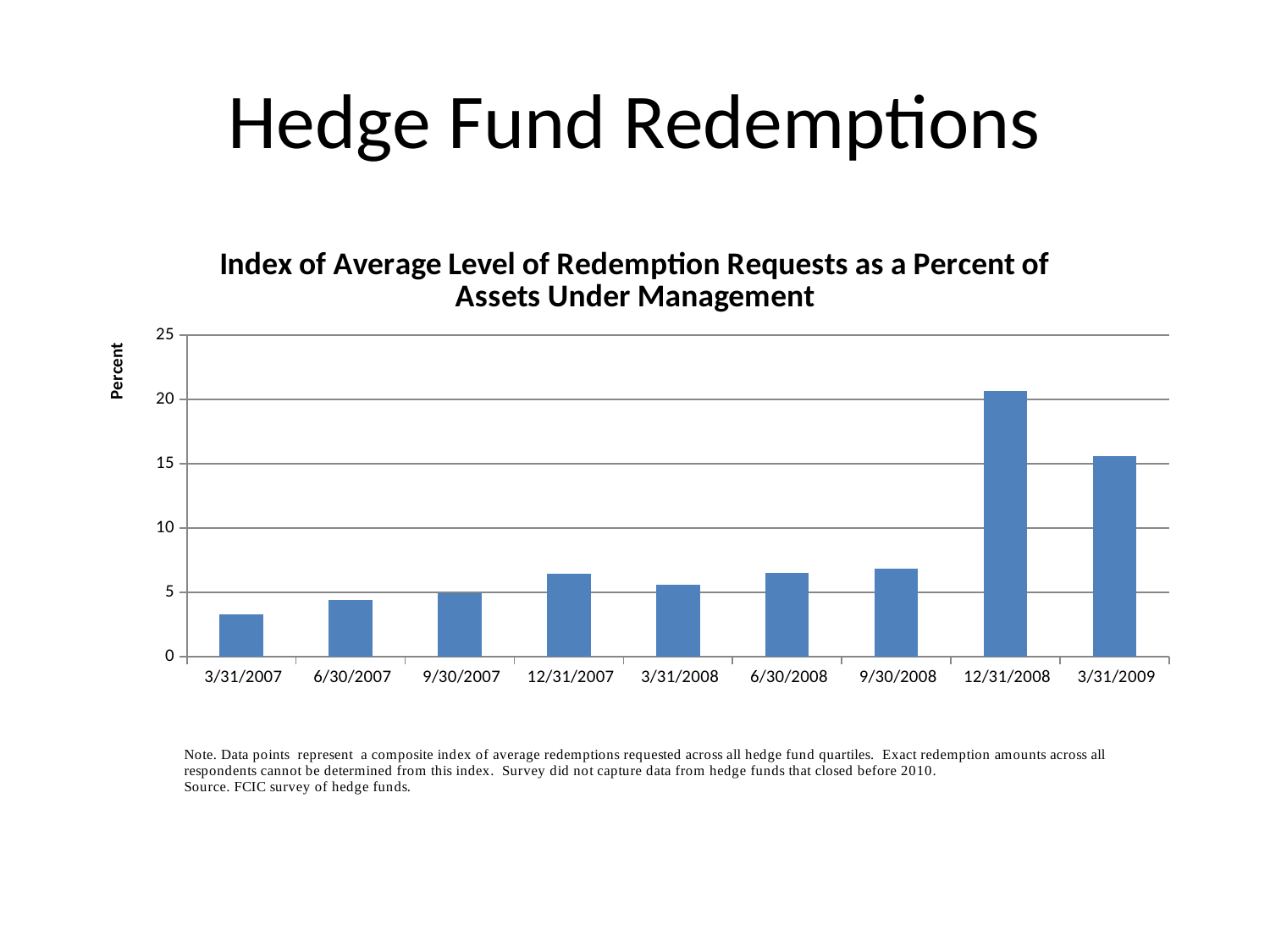
Is the value for 3/31/2009 greater or less than 15? greater Is the value for 12/31/2008 greater or less than 20? greater Which date has the lowest value in the chart? 3/31/2007 Is the value for 9/30/2008 greater or less than 10? less What is the title of the chart? Index of Average Level of Redemption Requests as a Percent of Assets Under Management Which date has the highest value in the chart? 12/31/2008 Which is larger, the value for 12/31/2008 or the value for 3/31/2009? 12/31/2008 What kind of chart is shown on the slide? bar chart How many dates are plotted on the x axis? 9 Which is larger, the value for 9/30/2008 or the value for 3/31/2008? 9/30/2008 What is the label on the vertical axis of the chart? Percent